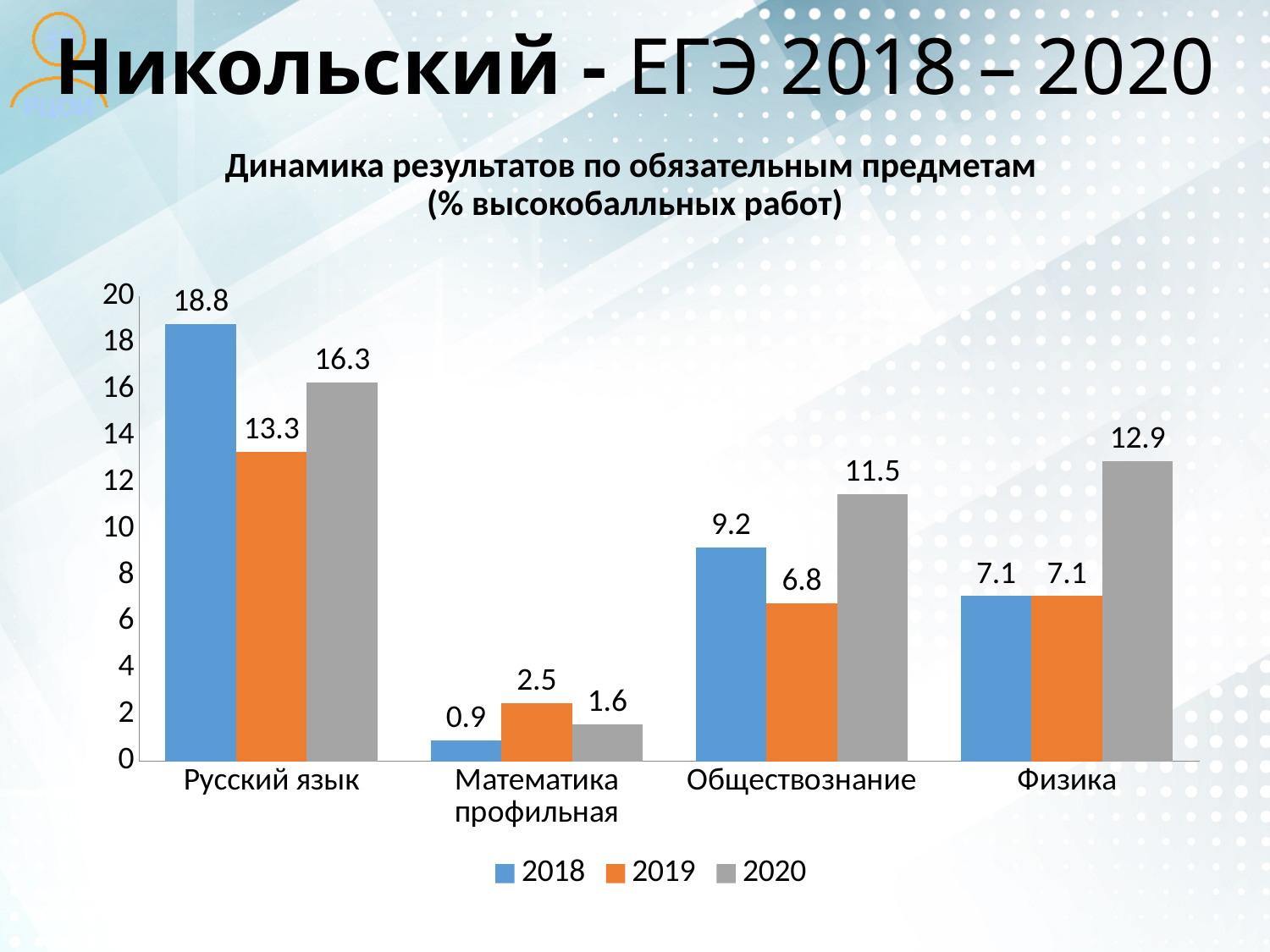
Which category has the lowest value in 2018? Математика профильная What is the value for Физика in 2020? 12.9 How many categories are shown on the x axis? 4 How many series does the legend list? 3 What is the value for Математика профильная in 2019? 2.5 What kind of chart is shown on the slide? bar chart Which category has the highest value in 2020? Русский язык What is the title of the chart? Динамика результатов по обязательным предметам (% высокобалльных работ) What is the value for Русский язык in 2018? 18.8 What is the difference between the 2018 and 2019 values for Русский язык? 5.5 Which is larger for Обществознание: the 2018 value or the 2020 value? 2020 Is the value for Обществознание in 2020 greater or less than 10? greater